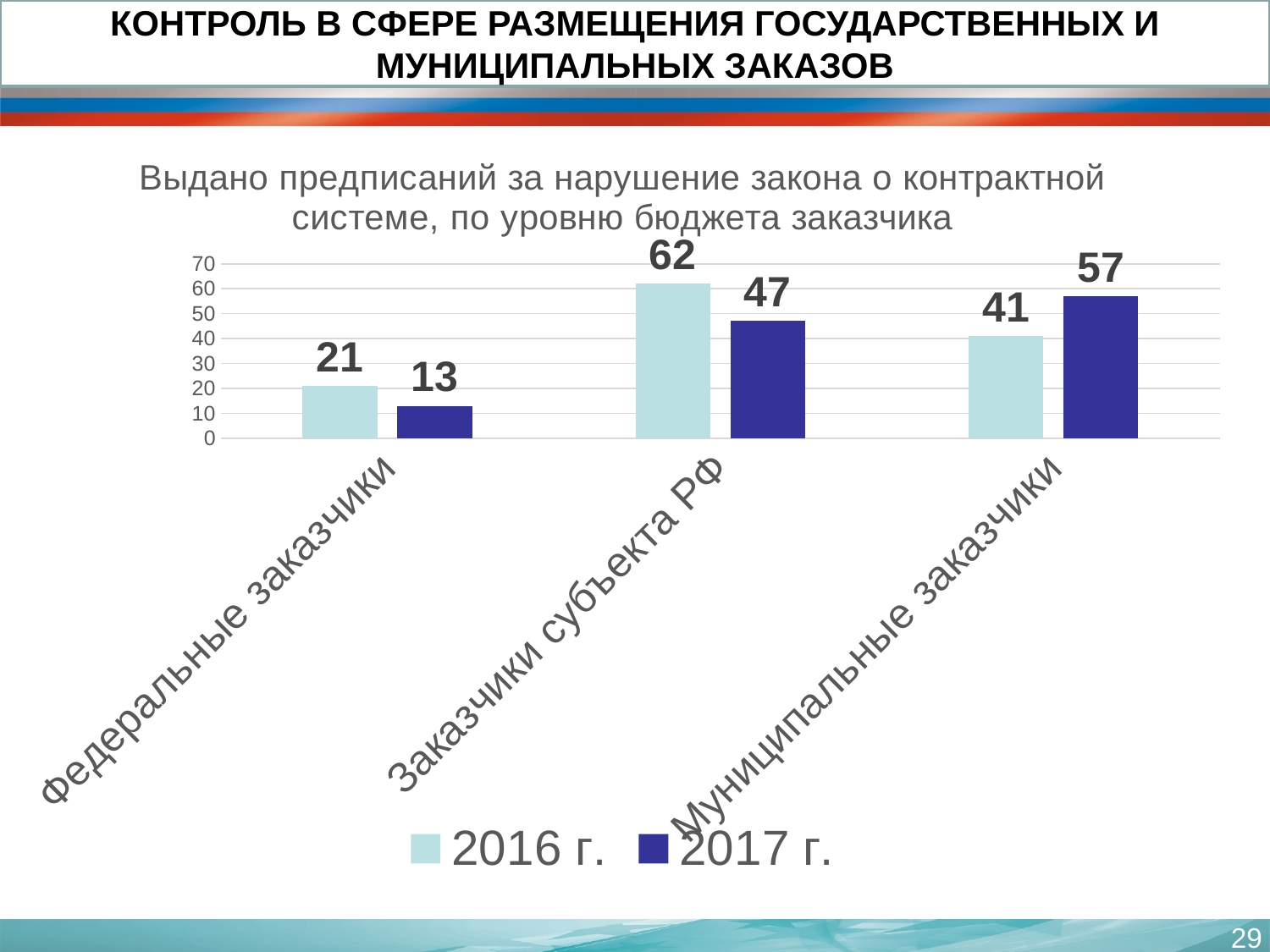
What is the value for Заказчики субъекта РФ in 2017 г.? 47 What is the difference between the 2016 г. and 2017 г. values for Заказчики субъекта РФ? 15 Which category has the lowest value in 2017 г.? Федеральные заказчики Which category has the highest value in 2016 г.? Заказчики субъекта РФ Is the value for Муниципальные заказчики in 2016 г. greater or less than 50? less Which is larger for Муниципальные заказчики: the 2016 г. value or the 2017 г. value? 2017 г. What is the title of the chart? Выдано предписаний за нарушение закона о контрактной системе, по уровню бюджета заказчика How many series does the legend list? 2 How many categories are shown on the x axis? 3 What is the value for Федеральные заказчики in 2016 г.? 21 What kind of chart is shown on the slide? bar chart What is the value for Муниципальные заказчики in 2017 г.? 57